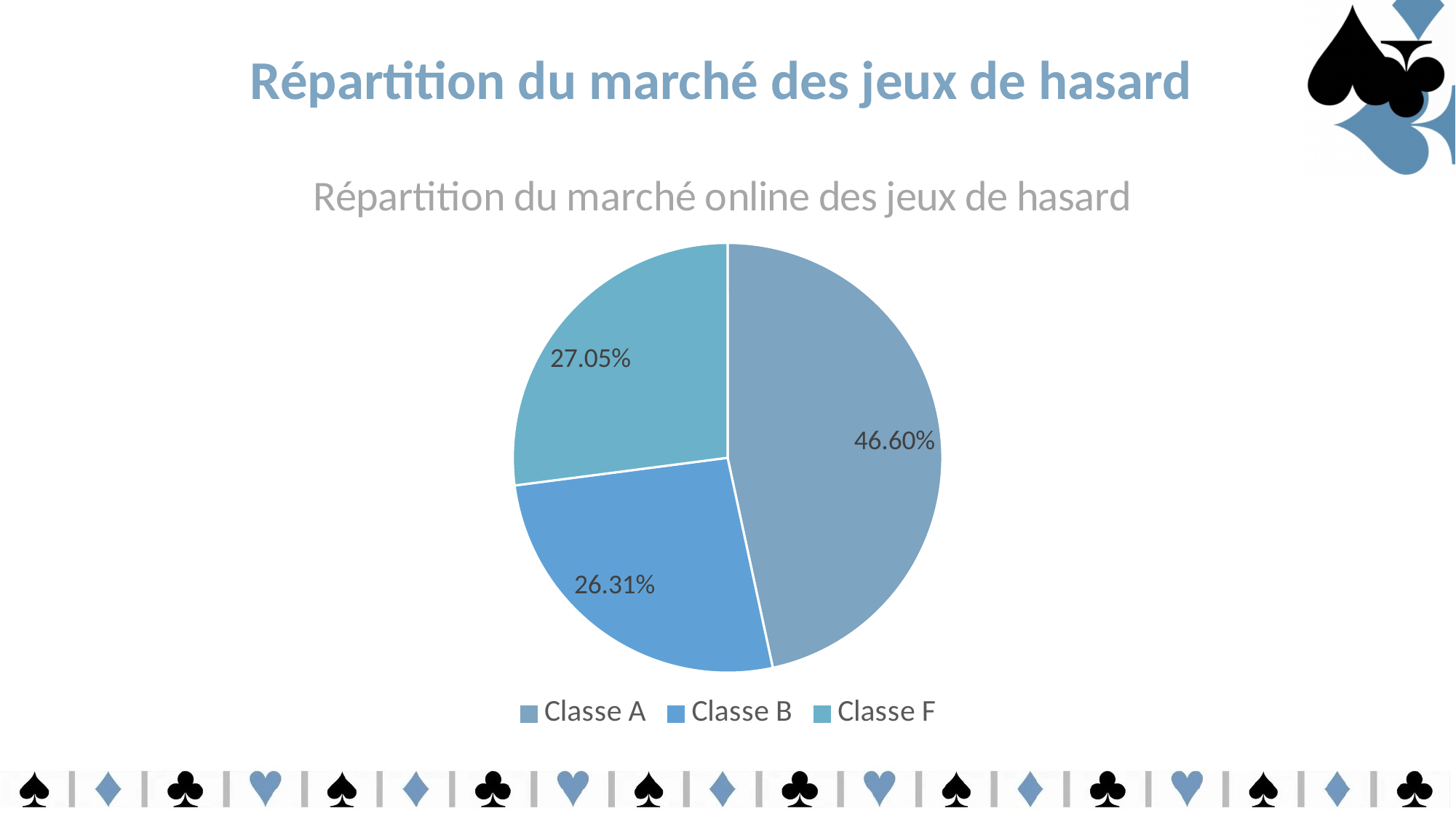
What share of the pie does Classe B hold? 26.31% What is the title of the chart? Répartition du marché online des jeux de hasard How many slices does the pie chart have? 3 What is the difference in percentage points between Classe A and Classe B? 20.29 What type of chart is shown on the slide? Pie chart What share of the pie does Classe F hold? 27.05% What is the difference in percentage points between Classe F and Classe B? 0.74 Which categories are listed in the chart legend? Classe A, Classe B, Classe F Which has a larger share, Classe B or Classe F? Classe F Which class has the smallest share of the online gambling market? Classe B What share of the pie does Classe A hold? 46.60% Which class has the largest share of the online gambling market? Classe A